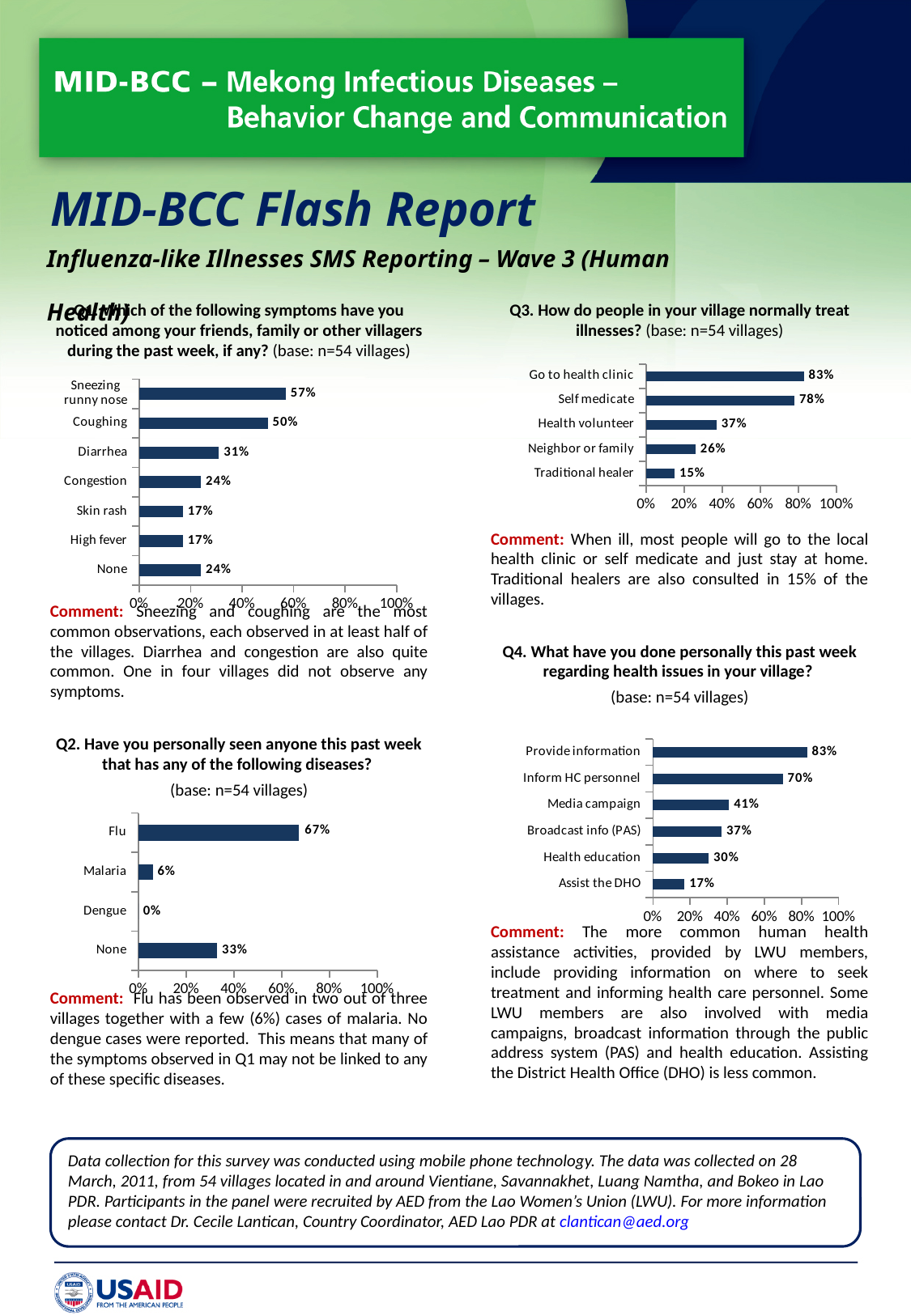
In the Q2 chart (diseases seen this past week), what is the difference between the values for Flu and None? 34% What type of chart is the Q4 chart (what you have done personally this past week)? Bar chart In the Q2 chart (diseases seen this past week), which category has the lowest value? Dengue In the Q1 chart (symptoms noticed during the past week), what is the value for Diarrhea? 31% In the Q3 chart (how people normally treat illnesses), how many categories are plotted? 5 In the Q2 chart (diseases seen this past week), what is the value for Malaria? 6% In the Q3 chart (how people normally treat illnesses), which is larger: Health volunteer or Neighbor or family? Health volunteer In the Q3 chart (how people normally treat illnesses), what is the value for Traditional healer? 15% In the Q4 chart (what you have done personally this past week), what is the difference between Provide information and Inform HC personnel? 13% In the Q1 chart (symptoms noticed during the past week), which category has the highest value? Sneezing runny nose In the Q1 chart (symptoms noticed during the past week), how many categories are plotted? 7 In the Q4 chart (what you have done personally this past week), what is the value for Media campaign? 41%